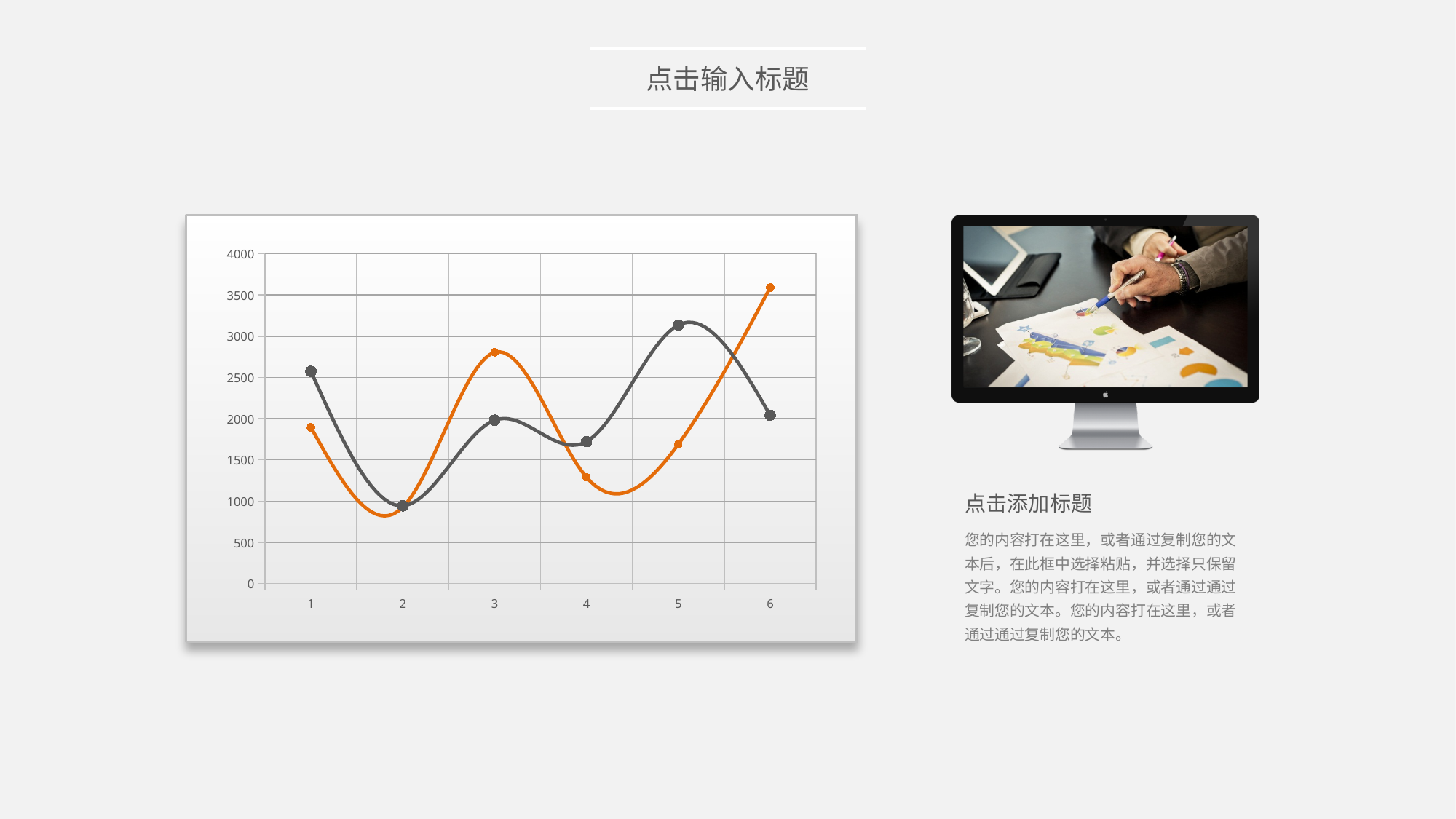
How many points are plotted along the x axis of the chart? 6 Does the orange line rise or fall from point 4 to point 6? rise At which x-axis point does the grey line reach its lowest value? 2 At point 3, which line has the higher value, the orange line or the grey line? orange line At which x-axis point does the grey line reach its highest value? 5 Is the value of the grey line at point 5 greater or less than 3000? greater What kind of chart is shown on the slide? line chart Is the value of the orange line at point 4 greater or less than 1500? less At point 1, which line has the higher value, the orange line or the grey line? grey line At which x-axis point does the orange line reach its highest value? 6 How many lines (series) are plotted in the chart? 2 Is the value of the orange line at point 6 greater or less than 3500? greater